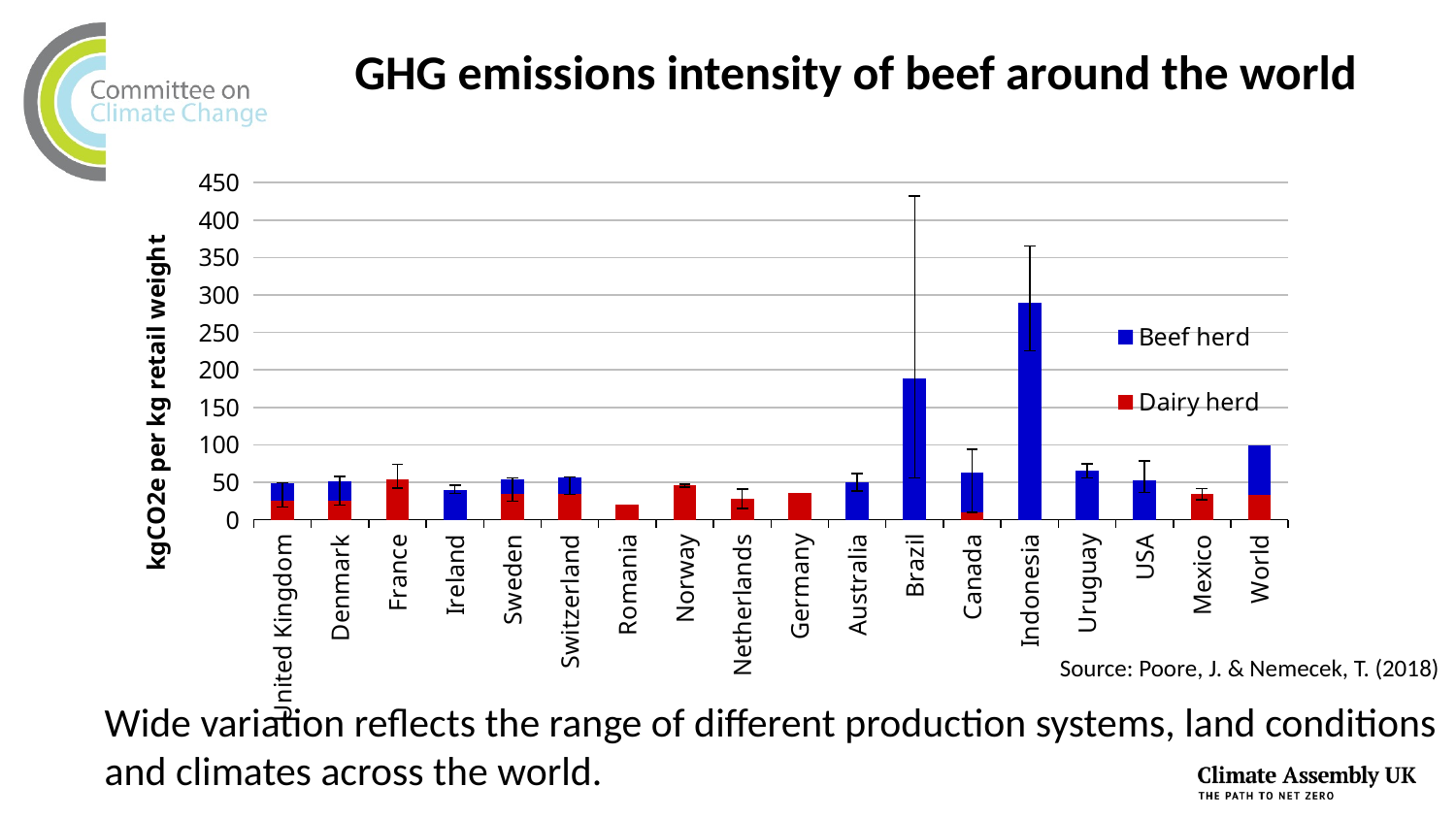
Which has the larger total GHG emissions intensity, Brazil or Canada? Brazil Is the total value for Indonesia greater or less than 250? greater Is the total value for Canada greater or less than 50? greater Which country has the lowest total GHG emissions intensity of beef in the chart? Romania Which colour represents the Beef herd series in the chart? Blue How many countries or regions are shown along the x axis of the chart? 18 Which country has the highest total GHG emissions intensity of beef in the chart? Indonesia Is the total value for Brazil greater or less than 150? greater What kind of chart is shown on the slide? Stacked bar chart What is the label on the vertical axis of the chart? kgCO2e per kg retail weight How many series does the chart legend list? 2